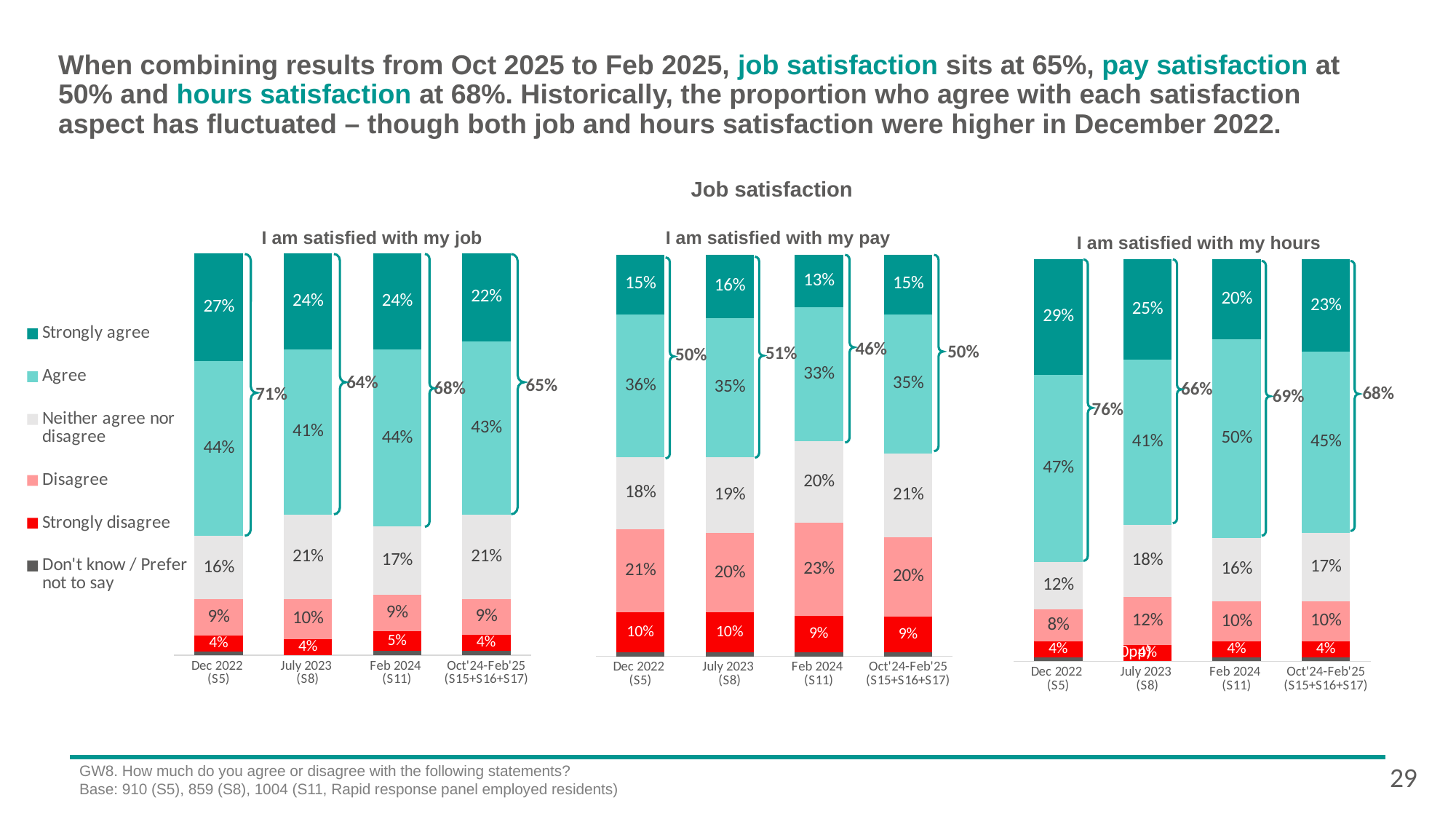
In the 'I am satisfied with my pay' chart, what percentage disagree in Feb 2024 (S11)? 23% In the 'I am satisfied with my pay' chart, which period has the lowest combined agree figure shown by the bracket? Feb 2024 (S11) In the 'I am satisfied with my job' chart, which period has the highest combined agree figure shown by the bracket? Dec 2022 (S5) In the 'I am satisfied with my job' chart, what percentage strongly agree in Dec 2022 (S5)? 27% How many series does the legend list? 6 What type of chart is used for 'I am satisfied with my hours'? Stacked bar chart In the 'I am satisfied with my hours' chart, what is the combined total of 'Strongly agree' and 'Agree' for July 2023 (S8)? 66% In the 'I am satisfied with my hours' chart, what percentage agree in Feb 2024 (S11)? 50% How many time periods are shown on the x axis of the 'I am satisfied with my pay' chart? 4 What is the overall title above the three charts? Job satisfaction In the 'I am satisfied with my job' chart, which is larger: the 'Neither agree nor disagree' share in July 2023 (S8) or in Feb 2024 (S11)? July 2023 (S8) In the 'I am satisfied with my hours' chart, what is the difference between the combined agree figure for Dec 2022 (S5) and Oct'24-Feb'25 (S15+S16+S17)? 8%